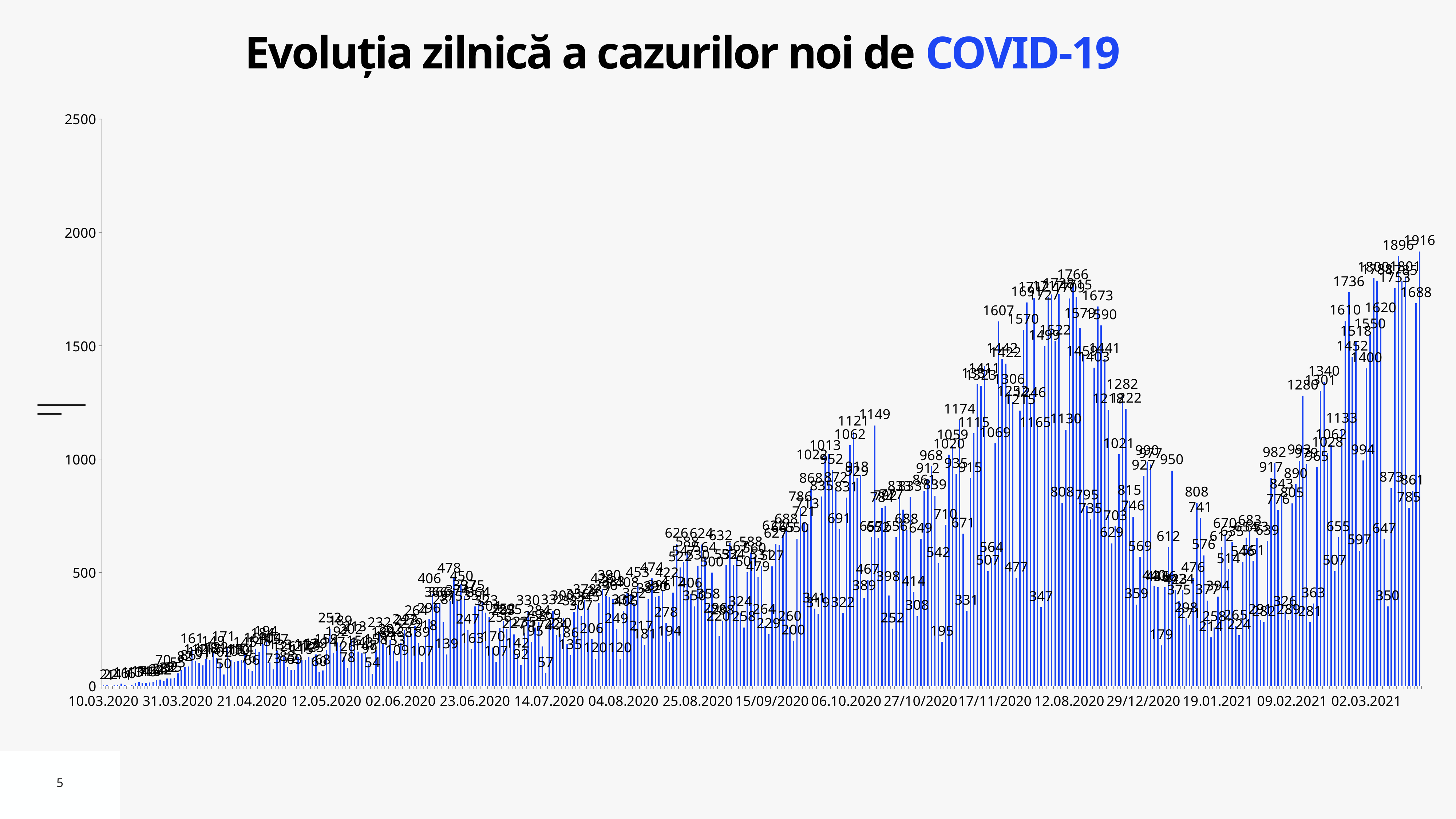
What is the difference between the highest value on the chart (1916) and the peak of the earlier wave (1766)? 150 What is the title of the chart? Evoluția zilnică a cazurilor noi de COVID-19 What is the last date label on the x axis? 02.03.2021 What is the highest value labeled on the chart? 1916 What is the maximum value shown on the y axis? 2500 Overall, do the values rise or fall from left to right along the x axis? rise Is the highest bar on the chart greater or less than 2000? less How many date labels are shown on the x axis? 18 What is the highest data label shown before the 29/12/2020 tick? 1766 What kind of chart is shown on the slide? bar chart What is the first date label on the x axis? 10.03.2020 Is the value for the first bar (10.03.2020) greater or less than 500? less